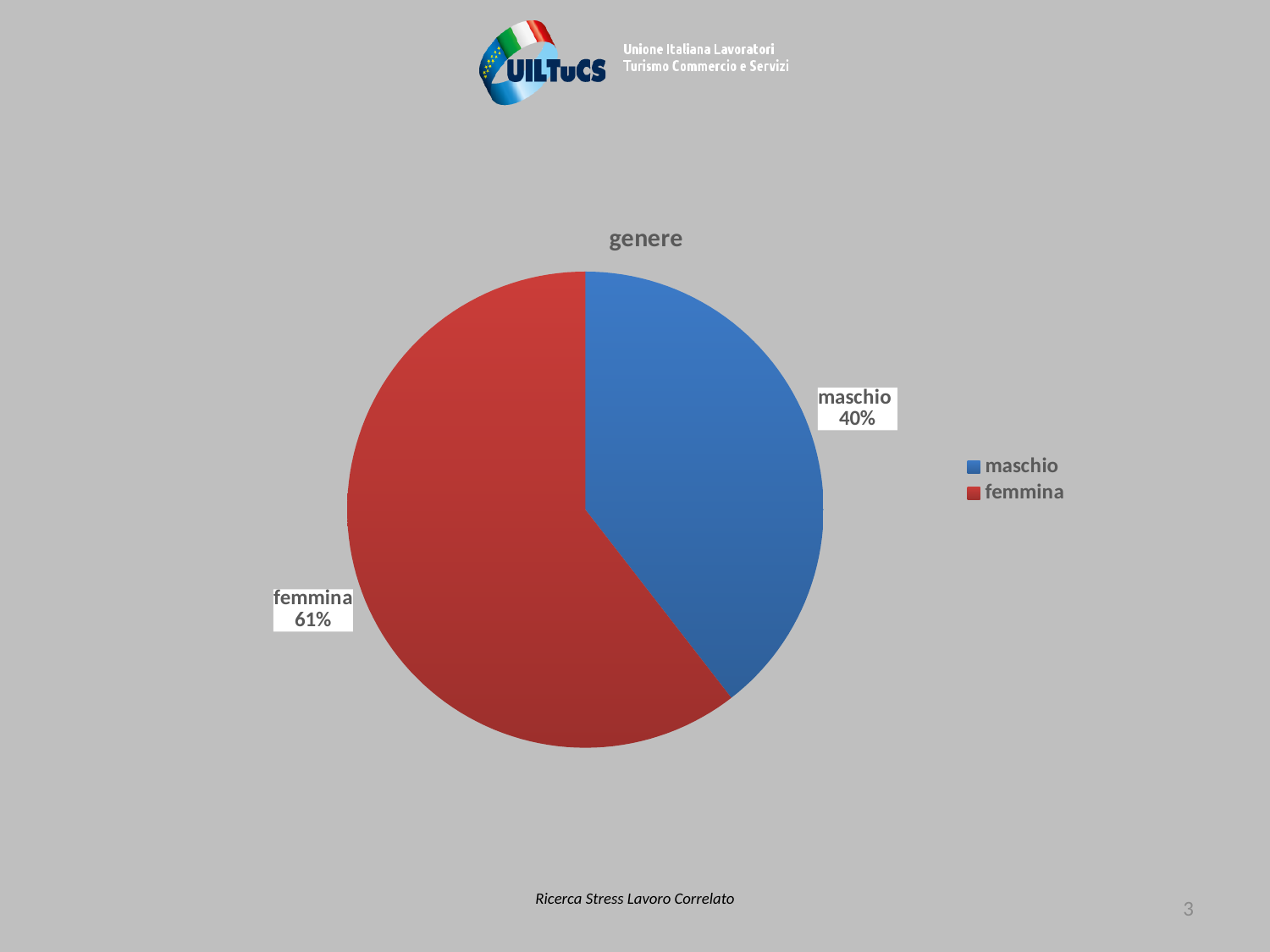
How many entries does the legend list? 2 Which category has the smallest share of the pie? maschio What colour is the femmina slice? red Which category has the largest share of the pie? femmina Which is larger, the share for maschio or the share for femmina? femmina What percentage of the pie is labelled femmina? 61% What percentage of the pie is labelled maschio? 40% How many slices does the pie chart have? 2 What is the difference in percentage points between the femmina and maschio shares? 21 What kind of chart is shown on the slide? pie chart What is the title of the chart? genere